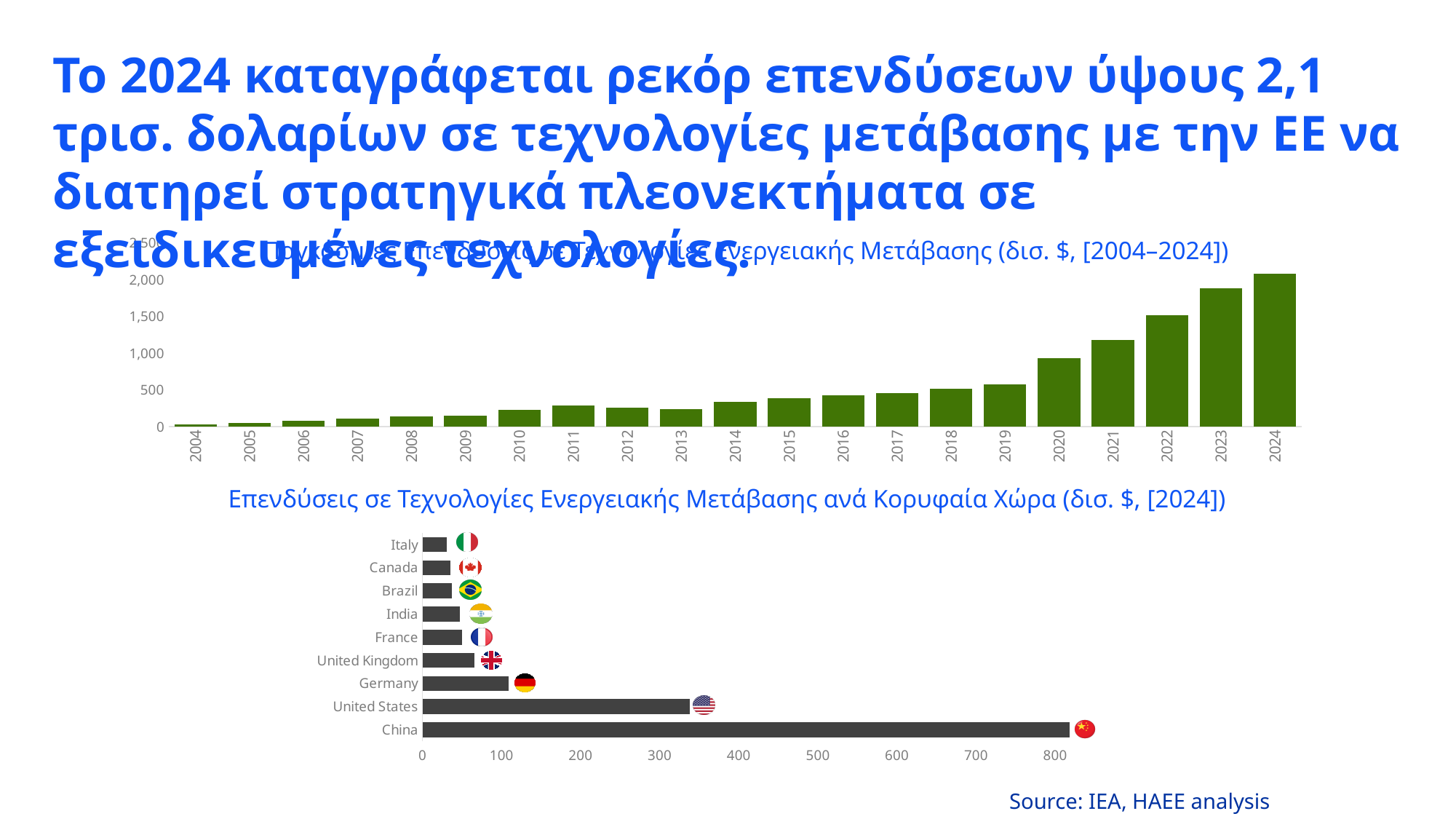
In the top chart, which year has the highest investment value? 2024 In the top chart, which year has the larger value, 2023 or 2020? 2023 In the top chart, do the values generally rise or fall from 2004 to 2024? rise In the bottom chart, how many countries are shown? 9 In the top chart, which year has the lowest investment value? 2004 In the top chart, how many years are plotted along the x axis? 21 In the top chart, is the value for 2016 greater or less than 500? less In the bottom chart, is the value for United States greater or less than 400? less In the top chart, is the value for 2021 greater or less than 1,000? greater In the bottom chart, which country has the highest investment value? China What kind of chart is the bottom chart (investments by top country, 2024)? bar chart What kind of chart is the top chart on the slide? bar chart